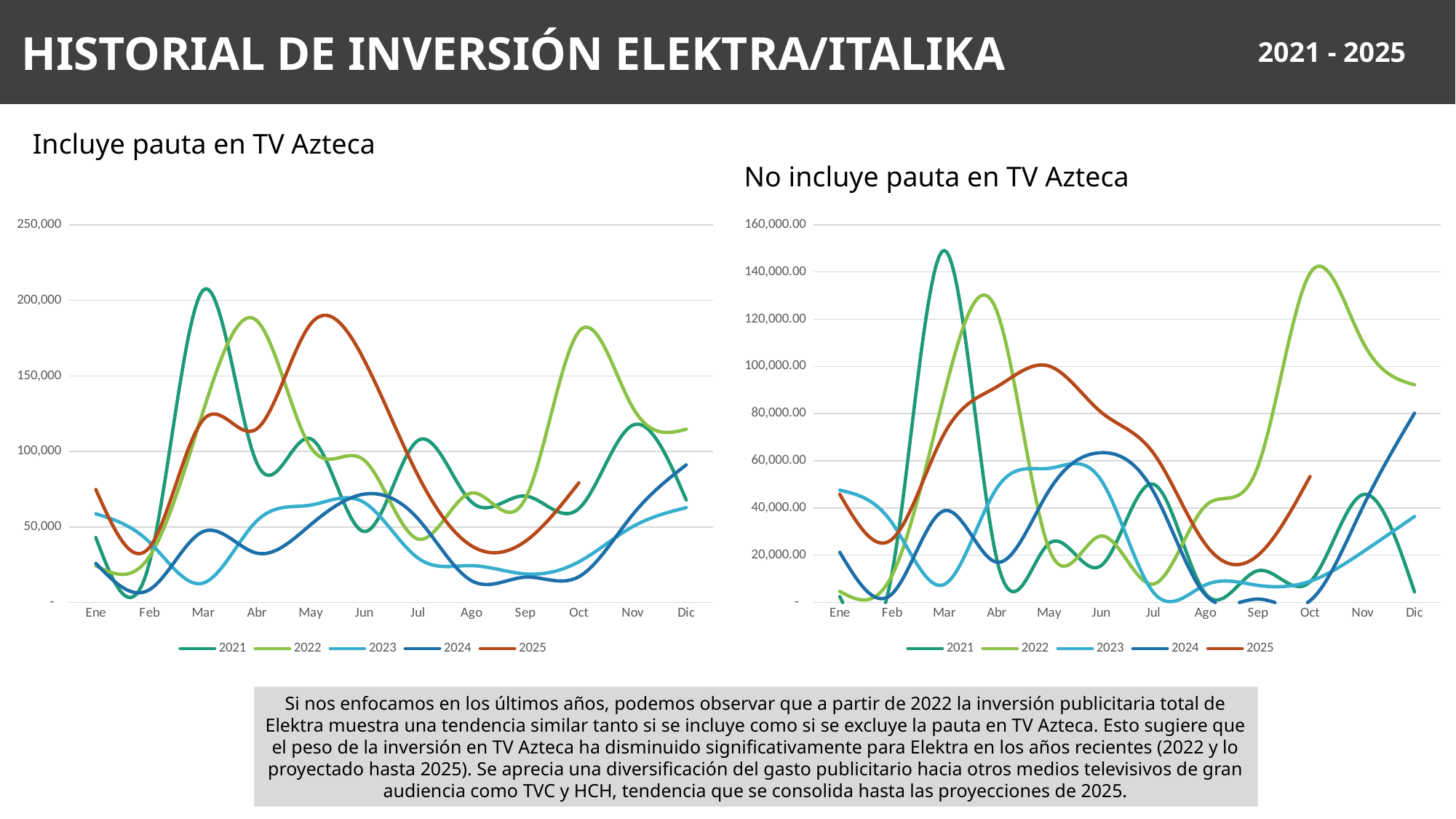
In the 'No incluye pauta en TV Azteca' chart, is the value for 2025 in May greater or less than 80,000.00? greater In the 'Incluye pauta en TV Azteca' chart, which is larger in Mar: the value for 2021 or the value for 2022? 2021 What is the title of the chart on the right side of the slide? No incluye pauta en TV Azteca What kind of chart is the 'Incluye pauta en TV Azteca' chart? line chart In the 'Incluye pauta en TV Azteca' chart, is the value for 2024 in Jun greater or less than 100,000? less In the 'Incluye pauta en TV Azteca' chart, which series reaches the highest value? 2021 How many months are shown on the x axis of the 'Incluye pauta en TV Azteca' chart? 12 In the 'Incluye pauta en TV Azteca' chart, in which month does the 2021 series reach its peak? Mar In the 'No incluye pauta en TV Azteca' chart, is the value for 2022 in Oct greater or less than 120,000.00? greater How many series does the legend of the 'No incluye pauta en TV Azteca' chart list? 5